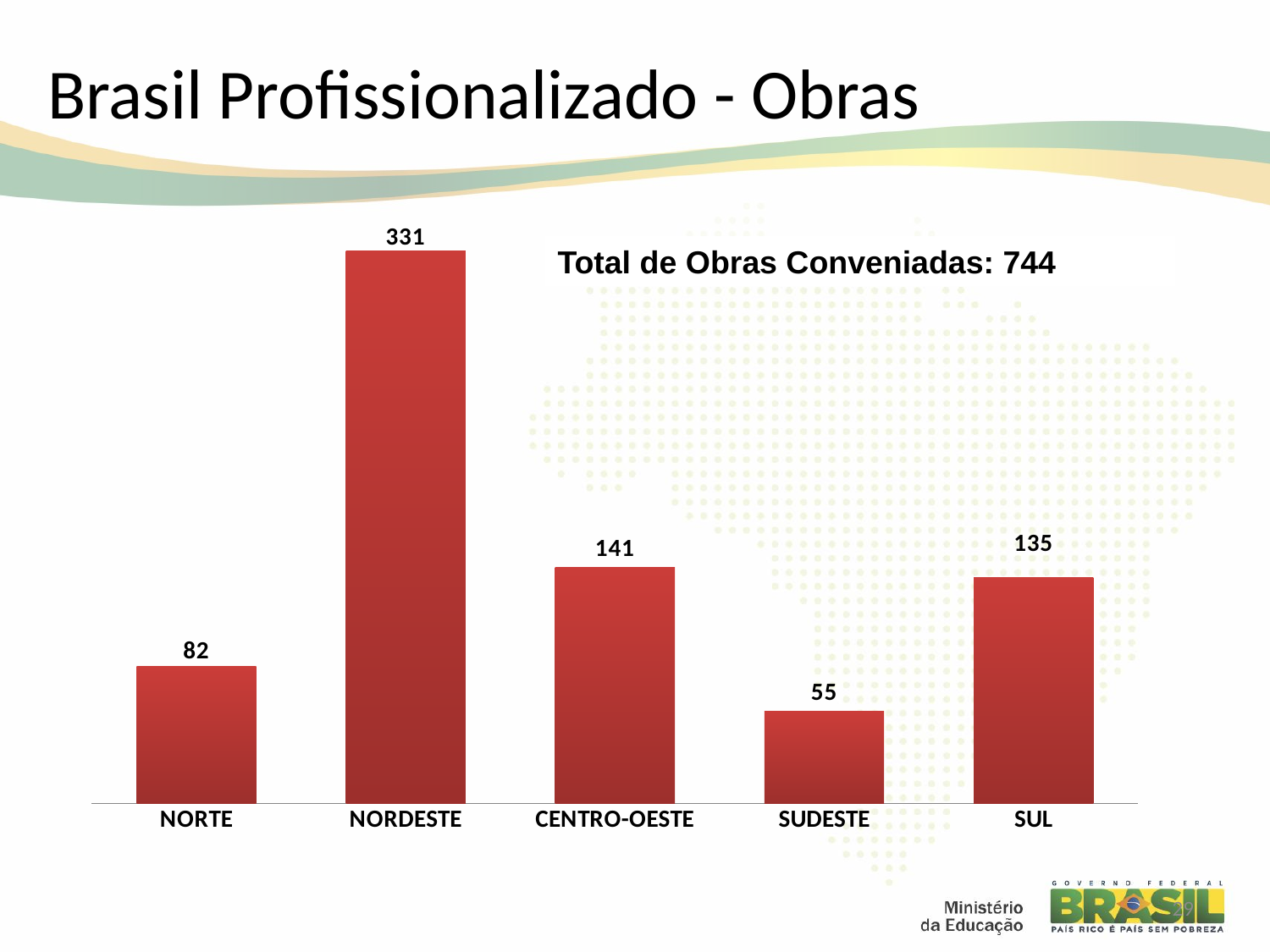
Which region has the highest value? NORDESTE What total number of works (obras conveniadas) is stated on the slide? 744 What is the difference between the values for NORDESTE and CENTRO-OESTE? 190 What is the difference between the values for NORTE and SUDESTE? 27 What is the value for NORTE? 82 Which region has the lowest value? SUDESTE Which is larger, the value for CENTRO-OESTE or the value for SUL? CENTRO-OESTE What kind of chart is shown on the slide? bar chart What is the value for SUL? 135 What is the value for SUDESTE? 55 How many regions are shown on the chart? 5 What is the value for NORDESTE? 331